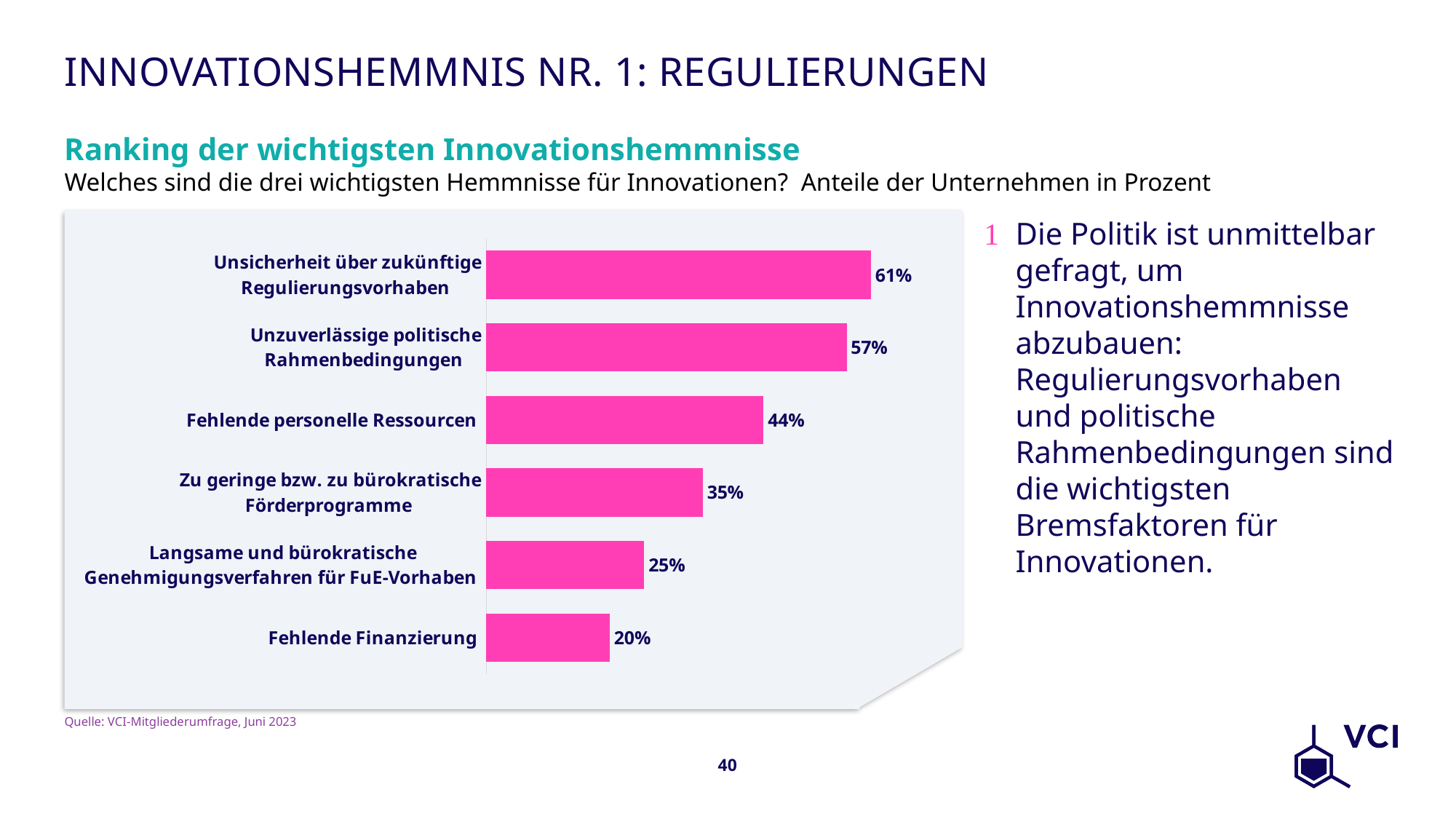
How many categories are shown in the chart? 6 What is the difference between the values for "Unzuverlässige politische Rahmenbedingungen" and "Zu geringe bzw. zu bürokratische Förderprogramme"? 22% What is the value for "Fehlende personelle Ressourcen"? 44% What is the title of the chart? Ranking der wichtigsten Innovationshemmnisse Which is larger: the value for "Fehlende personelle Ressourcen" or the value for "Fehlende Finanzierung"? Fehlende personelle Ressourcen What kind of chart is shown on the slide? Bar chart What colour are the bars in the chart? Pink What is the value for "Unsicherheit über zukünftige Regulierungsvorhaben"? 61% What is the difference between the highest and lowest values in the chart? 41% What is the value for "Langsame und bürokratische Genehmigungsverfahren für FuE-Vorhaben"? 25% Which category has the highest value? Unsicherheit über zukünftige Regulierungsvorhaben Which category has the lowest value? Fehlende Finanzierung